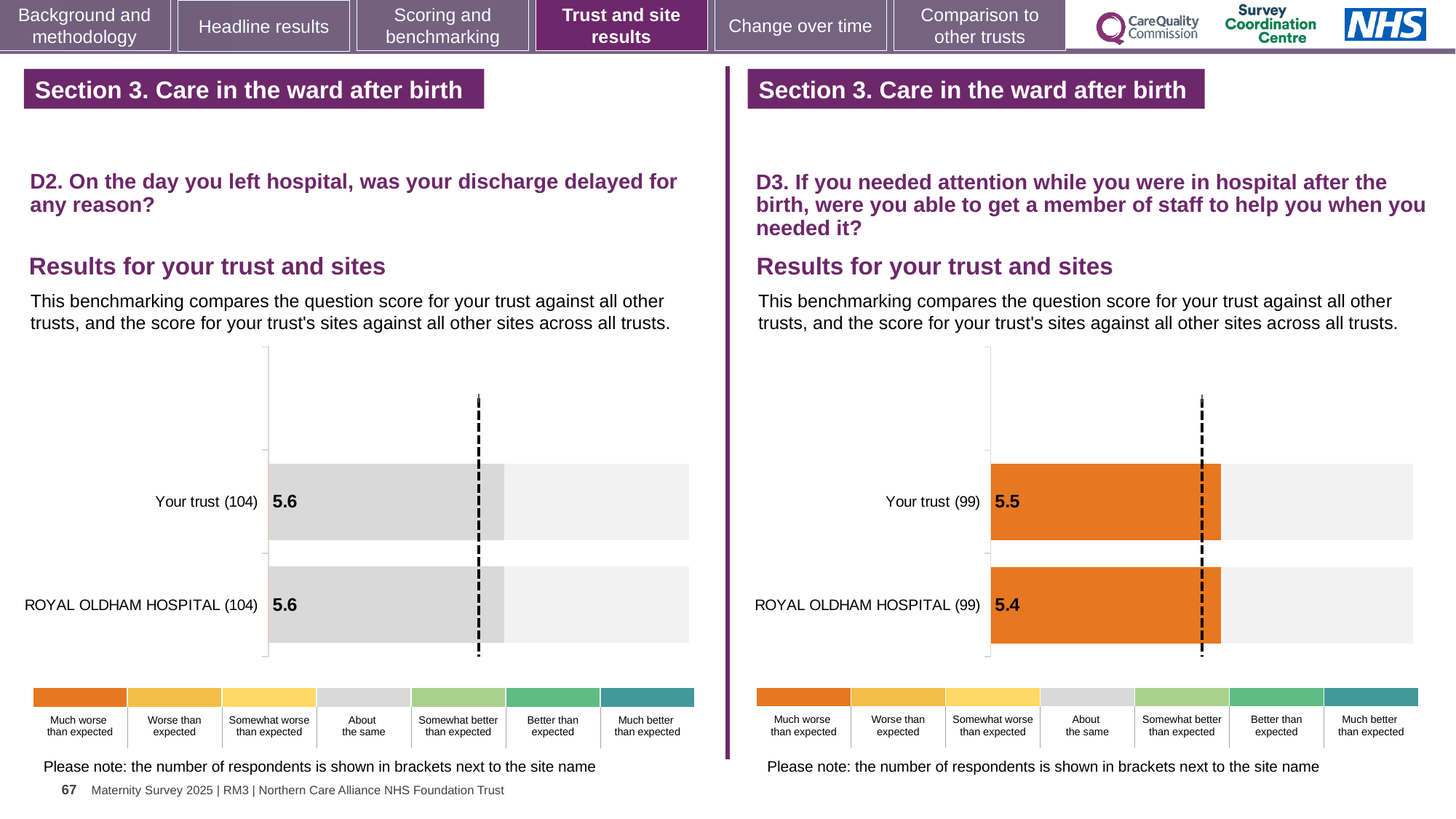
How many bars are plotted in the D3 chart on the right? 2 How many bars are plotted in the D2 chart on the left? 2 In the D3 chart on the right, which benchmarking category does the orange colour of the bars correspond to in the legend? Much worse than expected In the D3 chart on the right, how many respondents are shown in brackets for Your trust? 99 In the D2 chart on the left, what is the score for ROYAL OLDHAM HOSPITAL? 5.6 In the D3 chart on the right, what is the score for Your trust? 5.5 In the D3 chart on the right, what is the score for ROYAL OLDHAM HOSPITAL? 5.4 What type of chart is used for the D3 results on the right? Bar chart In the D2 chart on the left, what is the score for Your trust? 5.6 In the D2 chart on the left, what is the difference between the score for Your trust and the score for ROYAL OLDHAM HOSPITAL? 0 In the D3 chart on the right, what is the difference between the score for Your trust and the score for ROYAL OLDHAM HOSPITAL? 0.1 In the D3 chart on the right, which has the higher score, Your trust or ROYAL OLDHAM HOSPITAL? Your trust